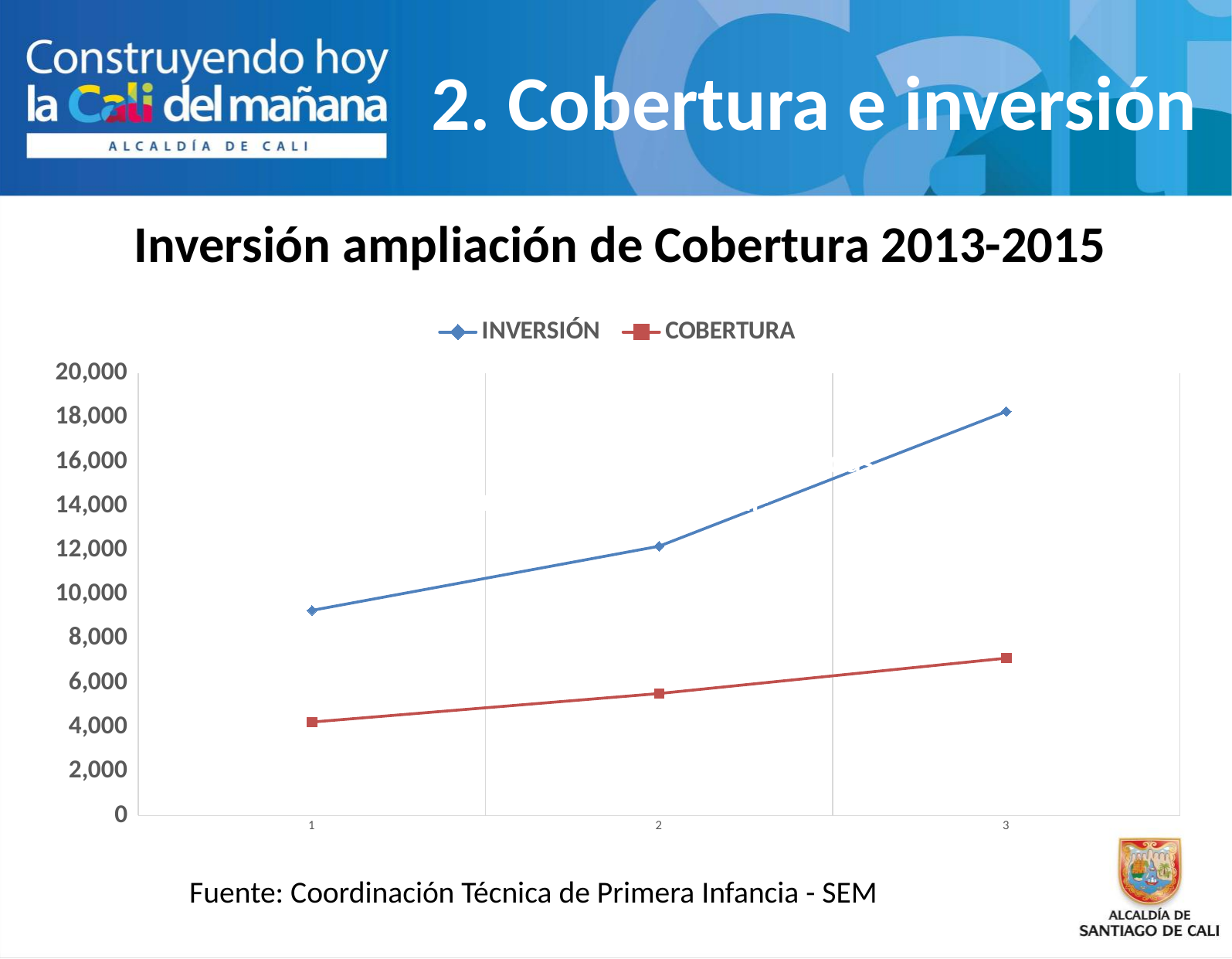
What is the title of the chart? Inversión ampliación de Cobertura 2013-2015 At which x-axis point is INVERSIÓN highest? 3 What kind of chart is shown on the slide? line chart How many points are plotted along the x axis for each series? 3 Does the COBERTURA series rise or fall along the x axis? rise Does the INVERSIÓN series rise or fall from point 1 to point 3? rise At which x-axis point is COBERTURA lowest? 1 Is the INVERSIÓN value at point 1 greater or less than 10,000? less Is the COBERTURA value at point 3 greater or less than 6,000? greater Is the INVERSIÓN value at point 3 greater or less than 16,000? greater At point 2, which series has the larger value, INVERSIÓN or COBERTURA? INVERSIÓN How many series does the legend list? 2